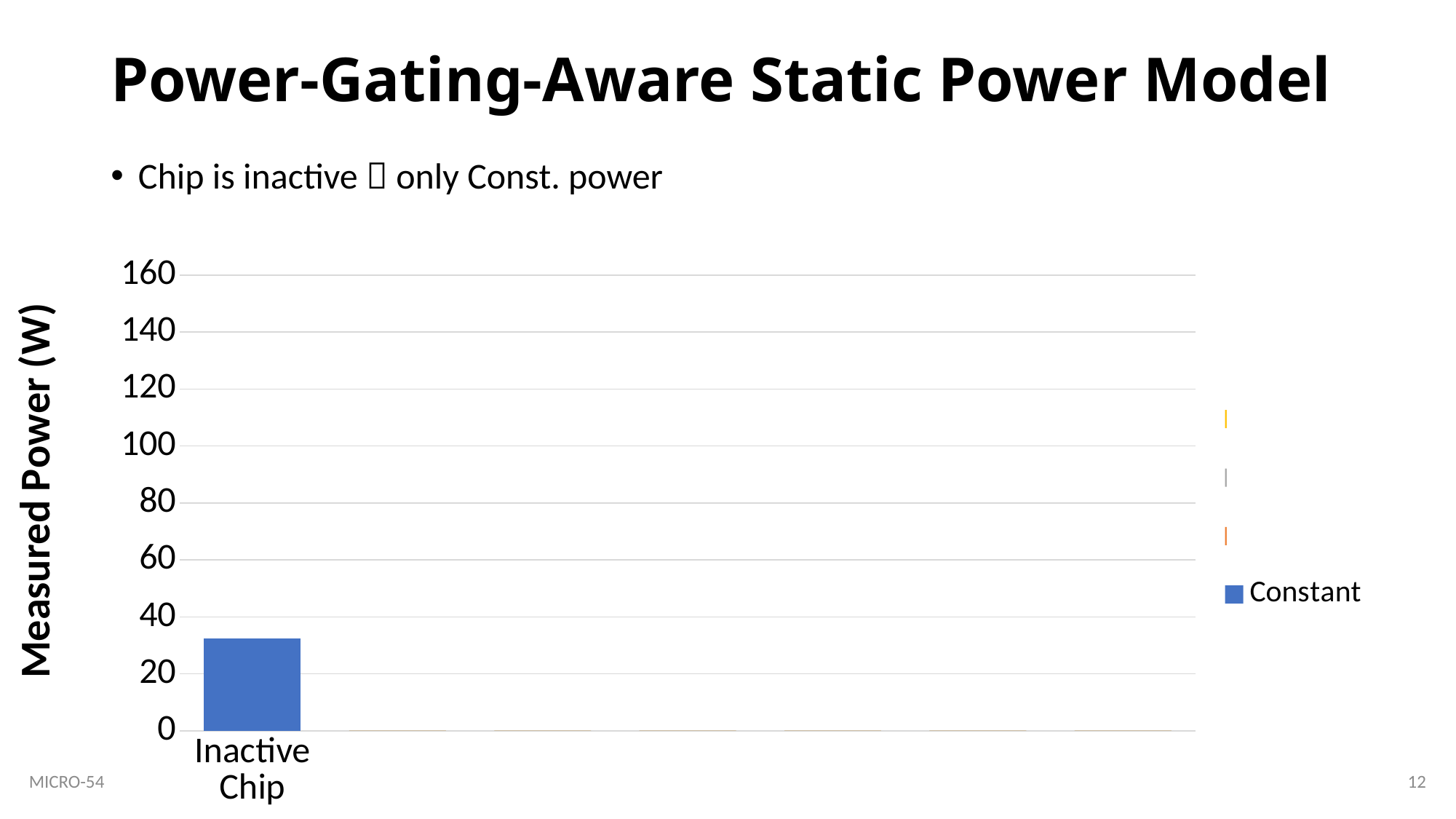
What is the label of the only category shown on the x axis? Inactive Chip Is the value for Inactive Chip greater or less than 20? greater Is the value for Inactive Chip greater or less than 40? less What kind of chart is shown on the slide? bar chart What is the title of the vertical axis? Measured Power (W) Which series name is readable in the chart legend? Constant How many labeled categories appear on the x axis of the chart? 1 Is the value for Inactive Chip greater or less than 60? less What is the highest tick value shown on the vertical axis? 160